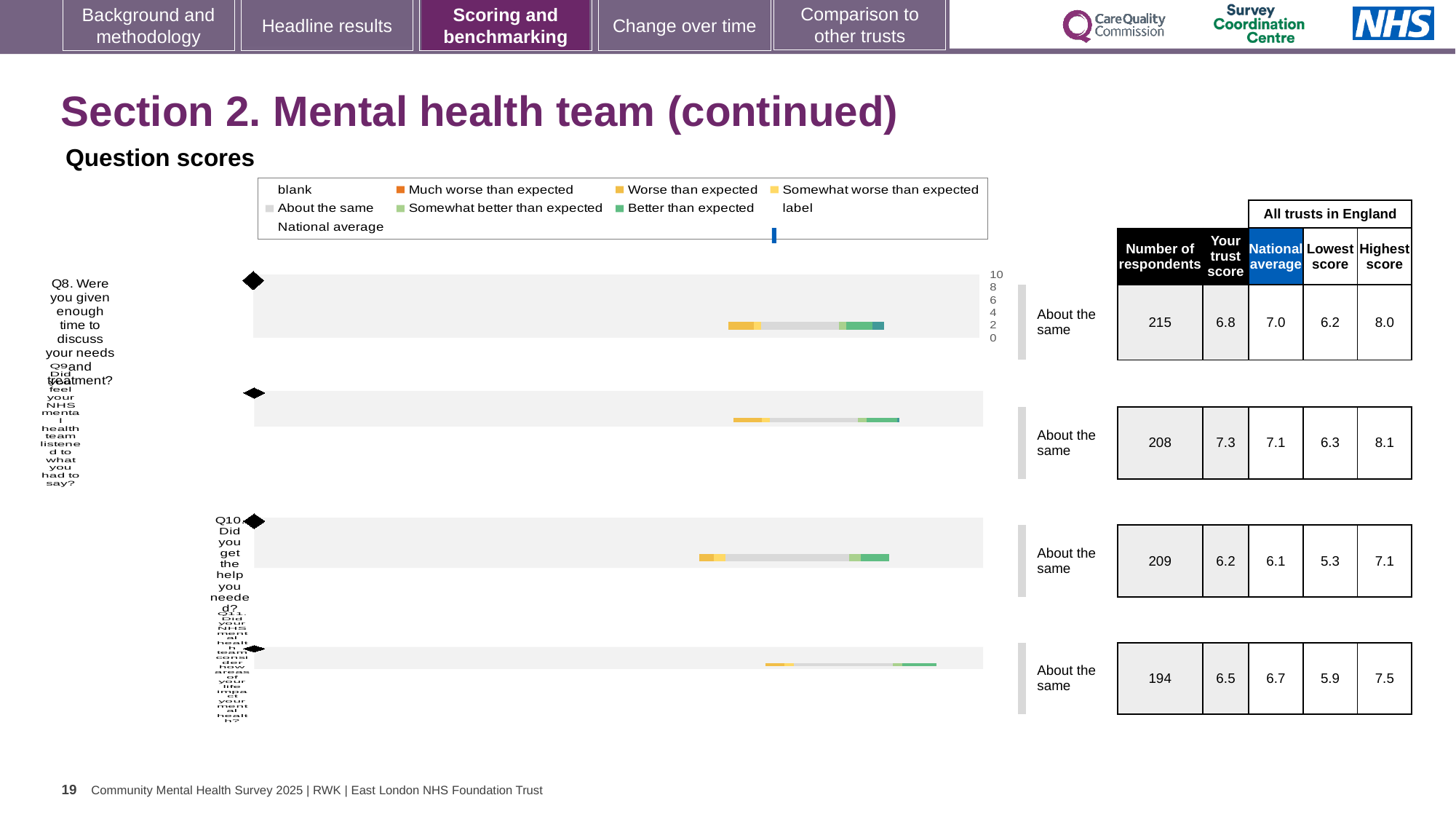
What benchmark category is shown next to the Q8 chart? About the same Which question row has the highest 'Your trust score'? Q9 What kind of chart is used for each question row? Bar chart Which question row has the lowest 'Your trust score'? Q10 For Q8, what is the difference between the national average and the trust score? 0.2 What is the 'Your trust score' value for Q9 (second row)? 7.3 What is the lowest score across all trusts in England for Q10? 5.3 In the Q8 row, how many respondents are shown in the table? 215 What is the national average for Q10 (third row)? 6.1 How many question rows (charts) are shown on the slide? 4 For Q9, which is larger: the trust score or the national average? Your trust score What is the highest score across all trusts in England for the fourth row (Q11)? 7.5